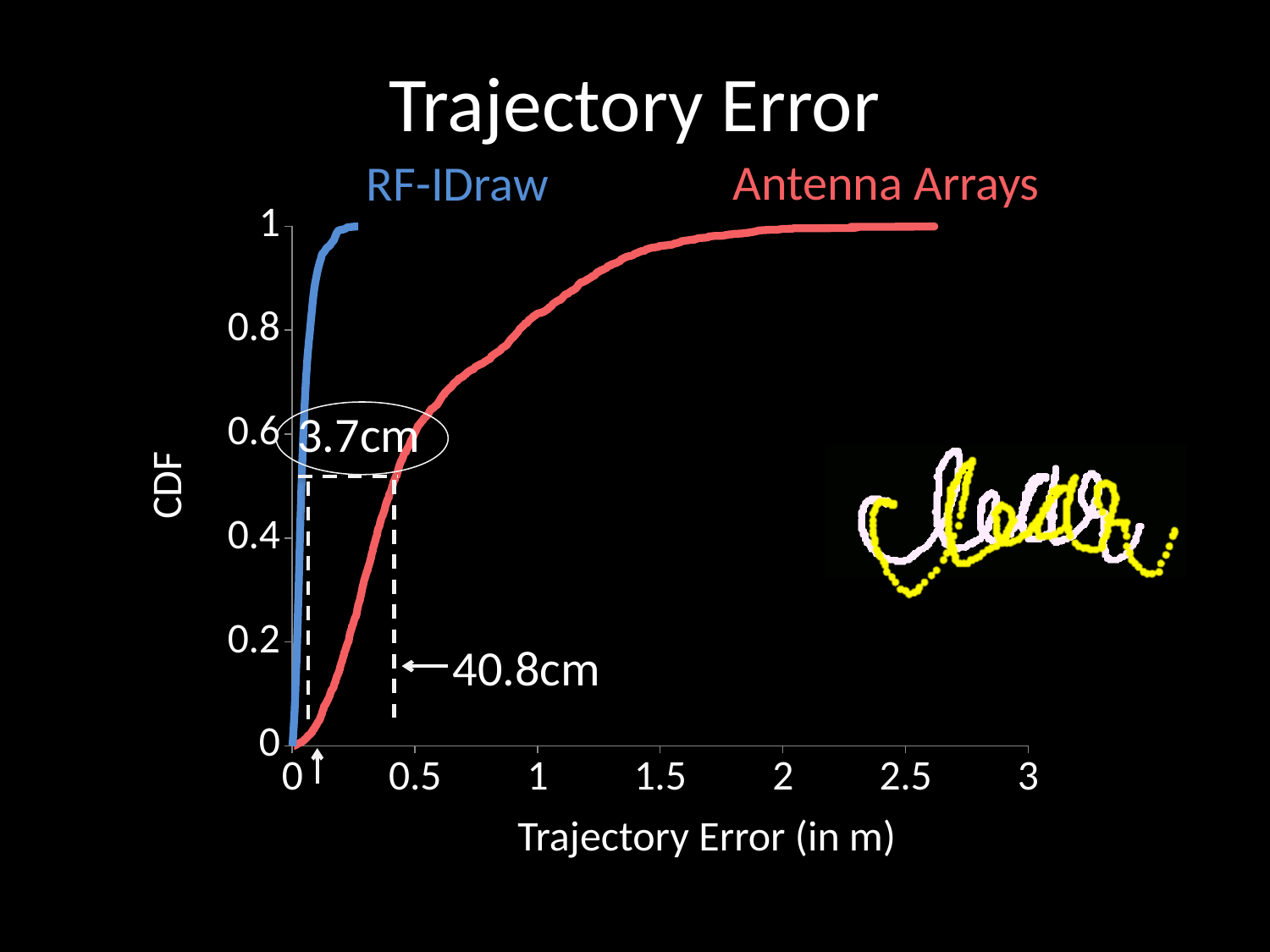
What is the label of the x axis? Trajectory Error (in m) Is the CDF value for Antenna Arrays at a trajectory error of 1 m greater or less than 0.6? greater What is the title of the chart? Trajectory Error What is the difference between the two annotated median trajectory errors? 37.1cm What is the label of the y axis? CDF How many series are plotted on the chart? 2 What median trajectory error is annotated for Antenna Arrays? 40.8cm Which series has the larger annotated median trajectory error, RF-IDraw or Antenna Arrays? Antenna Arrays What median trajectory error is annotated for RF-IDraw? 3.7cm Do the CDF values rise or fall as trajectory error increases along the x axis? rise What kind of chart is shown on the slide? line chart